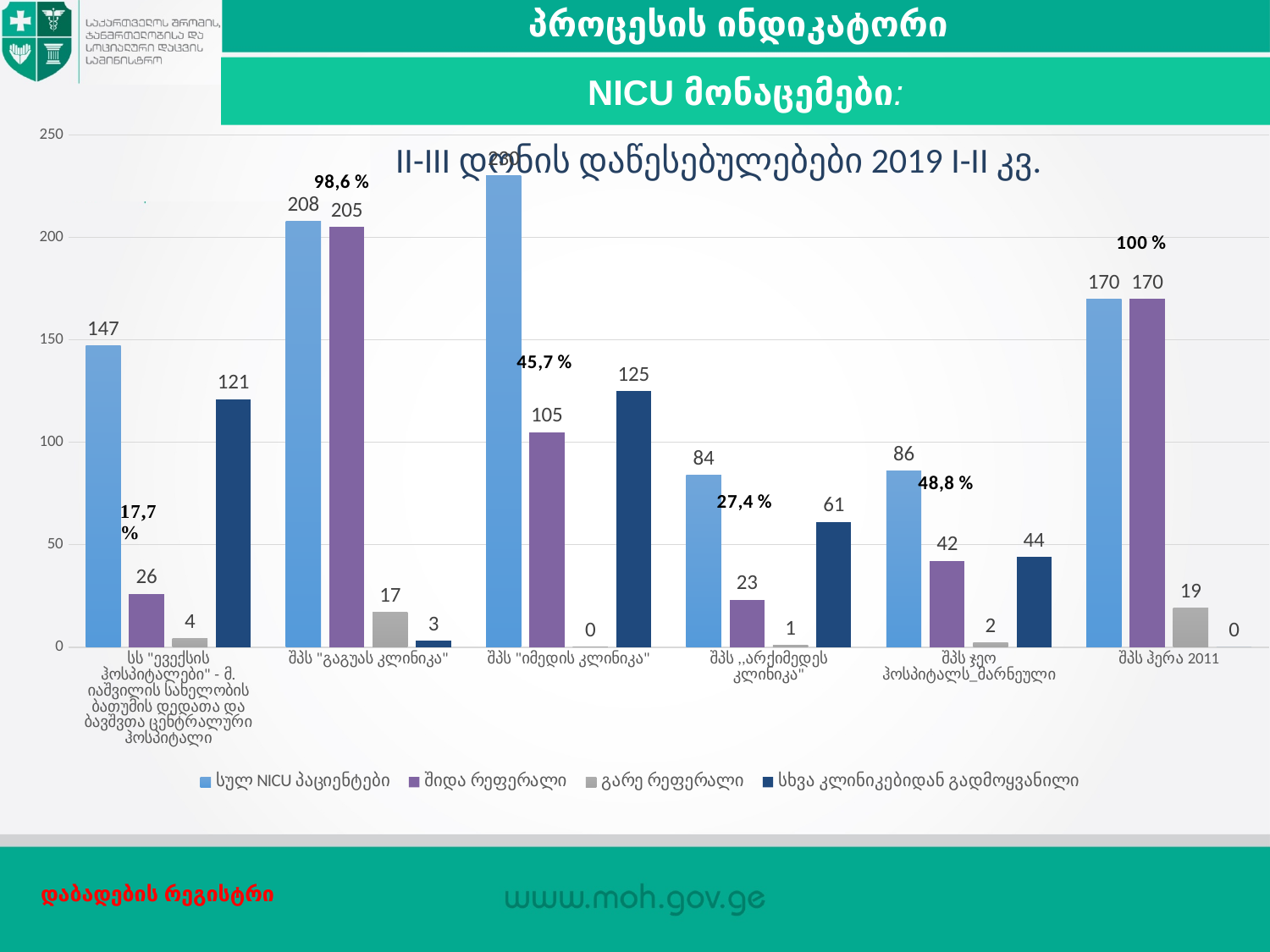
What percentage is shown above the bars for შპს პერა 2011? 100 % Which clinic has the highest სულ NICU პაციენტები value? შპს "იმედის კლინიკა" What type of chart is shown on the slide? bar chart What is the title of the chart? II-III დონის დაწესებულებები 2019 I-II კვ. What is the value of შიდა რეფერალი for შპს "იმედის კლინიკა"? 105 How many clinics (categories) are shown on the x axis? 6 Which clinic has the lowest სულ NICU პაციენტები value? შპს ,,არქიმედეს კლინიკა" Which is larger for შპს "გაგუას კლინიკა": გარე რეფერალი or სხვა კლინიკებიდან გადმოყვანილი? გარე რეფერალი What is the difference between სულ NICU პაციენტები and შიდა რეფერალი for შპს ჯეო ჰოსპიტალს მარნეული? 44 What is the value of სულ NICU პაციენტები for შპს "გაგუას კლინიკა"? 208 How many series does the legend list? 4 What is the value of სხვა კლინიკებიდან გადმოყვანილი for შპს ,,არქიმედეს კლინიკა"? 61